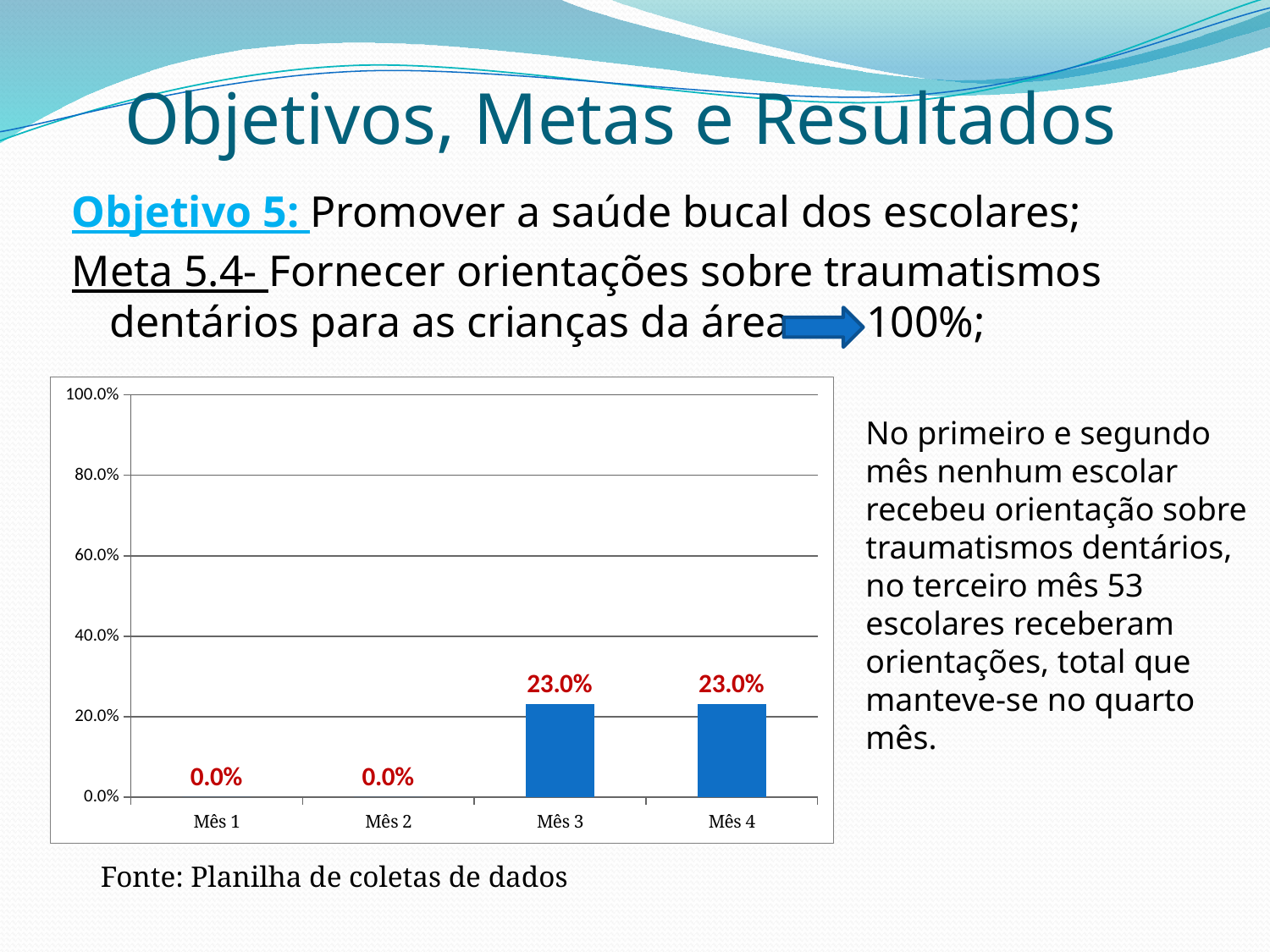
How many categories are shown on the x axis of the chart? 4 What colour are the bars in the chart? blue Do the values rise or fall from Mês 2 to Mês 3? rise What is the highest value shown on the y axis of the chart? 100.0% Which is larger, the value for Mês 4 or the value for Mês 1? Mês 4 Is the value for Mês 3 greater or less than 40.0%? less What is the difference between the values for Mês 3 and Mês 2? 23.0% What kind of chart is shown on the slide? bar chart What is the value for Mês 4? 23.0% What is the value for Mês 3? 23.0% What is the value for Mês 1? 0.0% What is the value for Mês 2? 0.0%